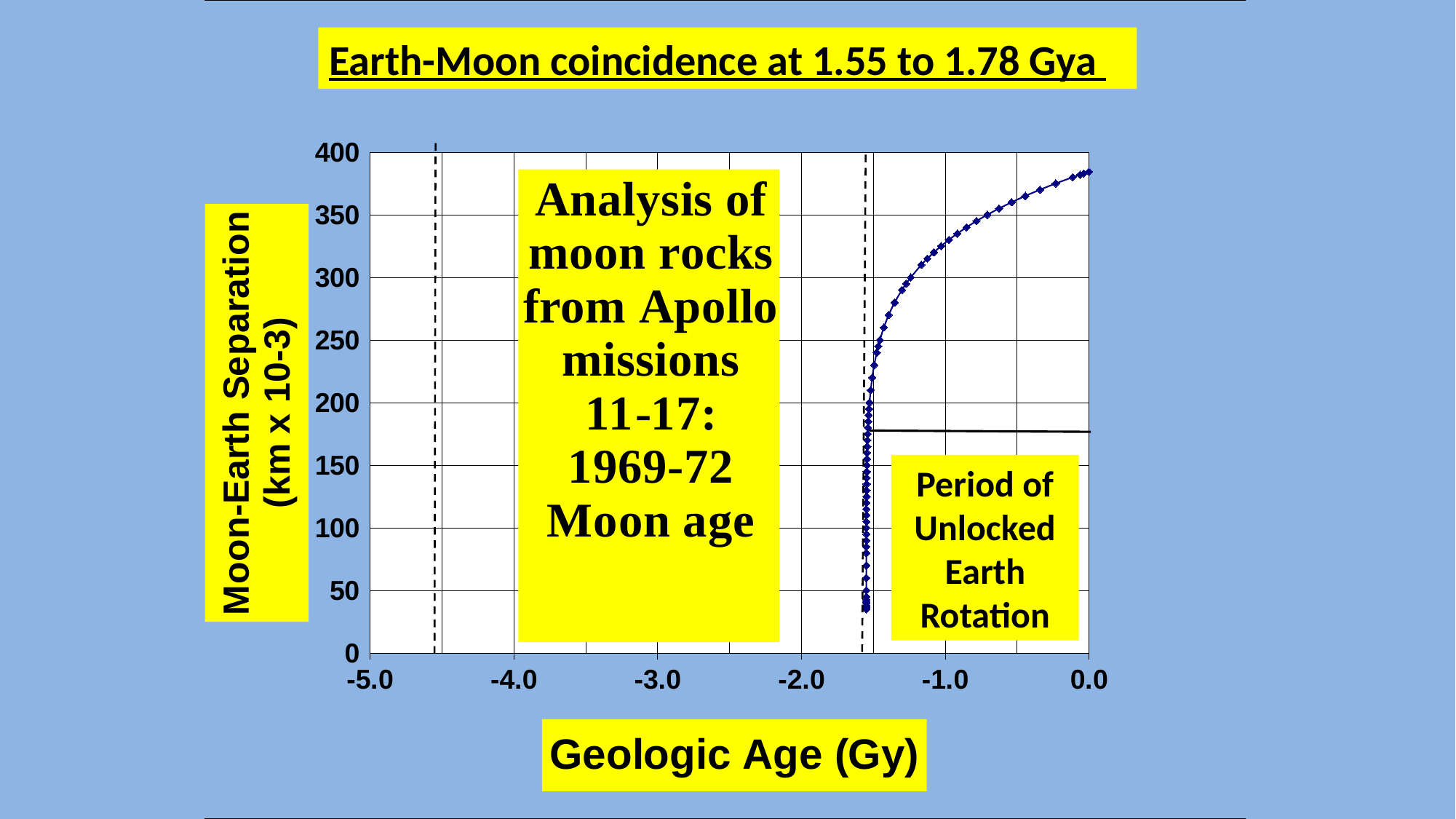
Is the Moon-Earth Separation at a Geologic Age of -1.5 Gy greater or less than 300? less How many labelled tick marks are on the x axis? 6 What is the maximum value shown on the y axis? 400 At which plotted Geologic Age is the Moon-Earth Separation highest? 0.0 Gy What is the label of the x axis? Geologic Age (Gy) Does the Moon-Earth Separation rise or fall as Geologic Age increases from -1.5 Gy toward 0.0 Gy? rise What is the title of the chart on the slide? Earth-Moon coincidence at 1.55 to 1.78 Gya Is the Moon-Earth Separation at a Geologic Age of -1.0 Gy greater or less than 300? greater Is the Moon-Earth Separation at a Geologic Age of -1.0 Gy greater or less than 400? less Which has the larger Moon-Earth Separation: Geologic Age 0.0 Gy or -1.0 Gy? 0.0 Gy What kind of chart is shown on the slide? line chart